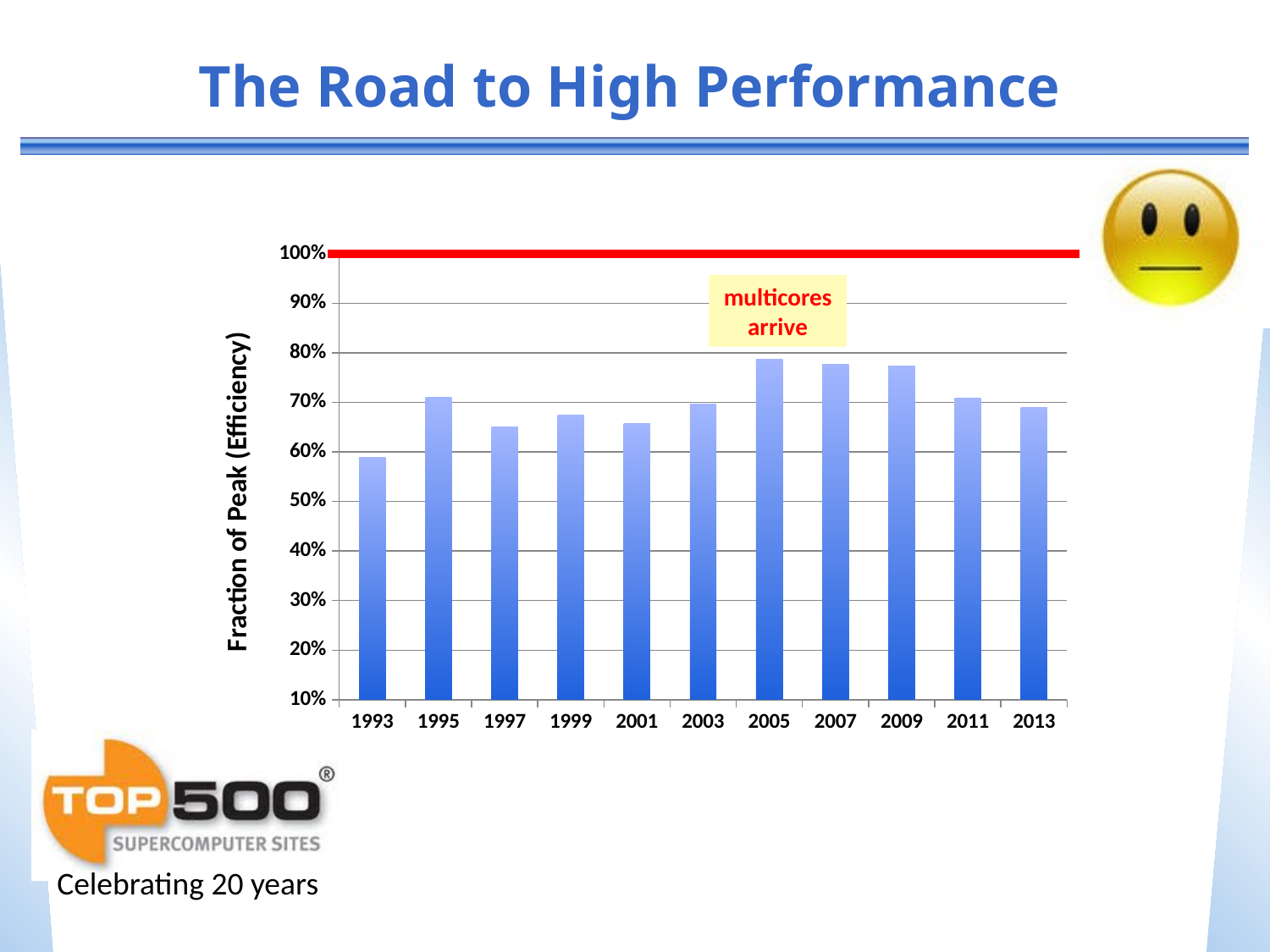
Which is larger, the value for 2005 or the value for 2013? 2005 Is the value for 2005 greater or less than 80%? less What is the label on the vertical axis of the chart? Fraction of Peak (Efficiency) Is the value for 1997 greater or less than 60%? greater Which year has the lowest fraction of peak efficiency? 1993 What kind of chart is shown on the slide? bar chart Is the value for 2001 greater or less than 70%? less What does the annotation above the 2005 and 2007 bars say? multicores arrive How many years are plotted on the x axis of the chart? 11 Which is larger, the value for 1993 or the value for 1995? 1995